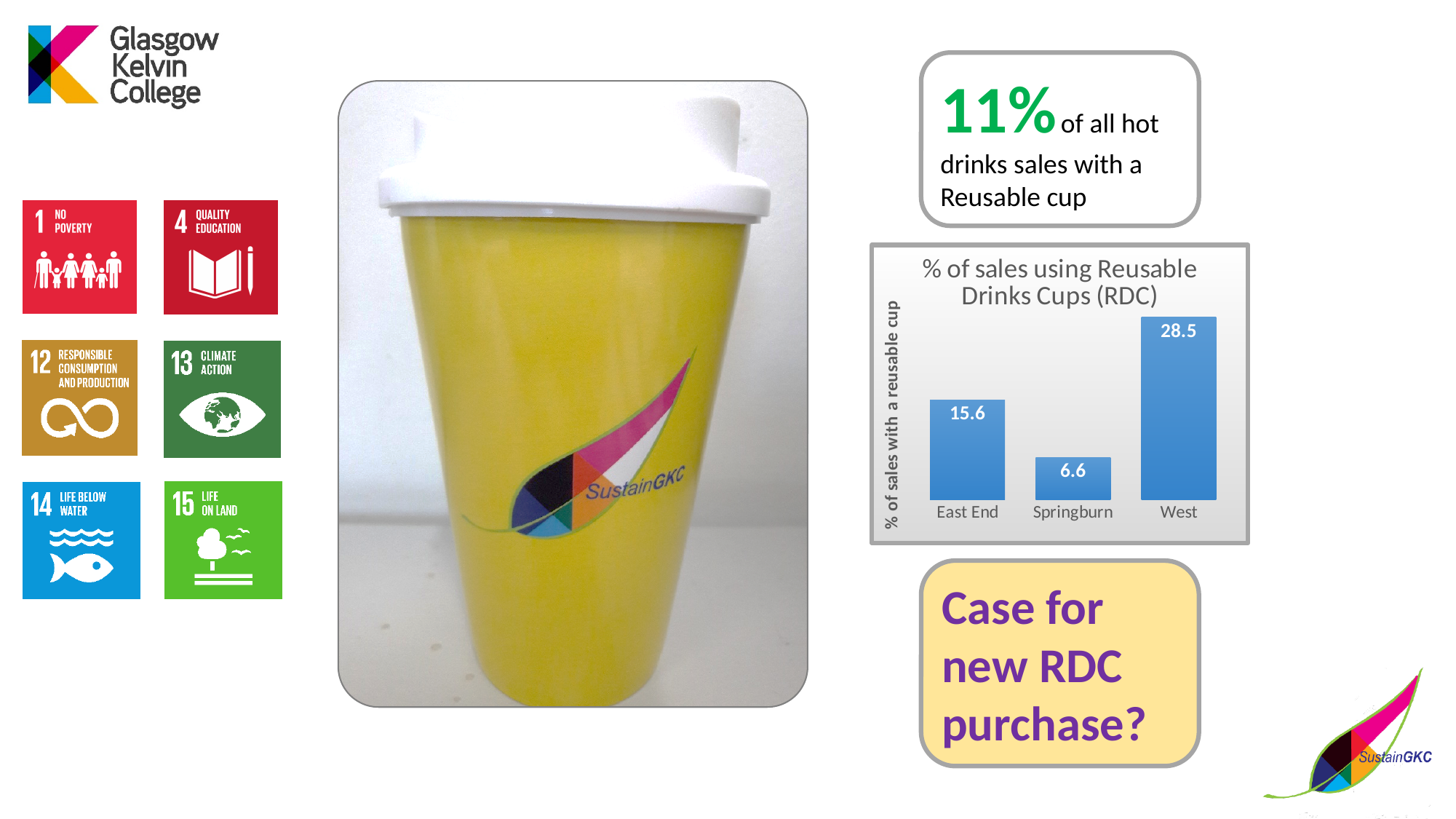
Which campus has the highest % of sales using reusable drinks cups? West How many campuses are shown in the chart? 3 What is the value for West in the chart? 28.5 What is the difference between the values for West and East End? 12.9 What is the difference between the values for East End and Springburn? 9 What is the label of the vertical axis of the chart? % of sales with a reusable cup Which campus has the lowest % of sales using reusable drinks cups? Springburn What is the value for Springburn in the chart? 6.6 Which is larger, the value for East End or the value for Springburn? East End What is the title of the chart? % of sales using Reusable Drinks Cups (RDC) What kind of chart is shown on the slide? Bar chart What is the value for East End in the chart? 15.6